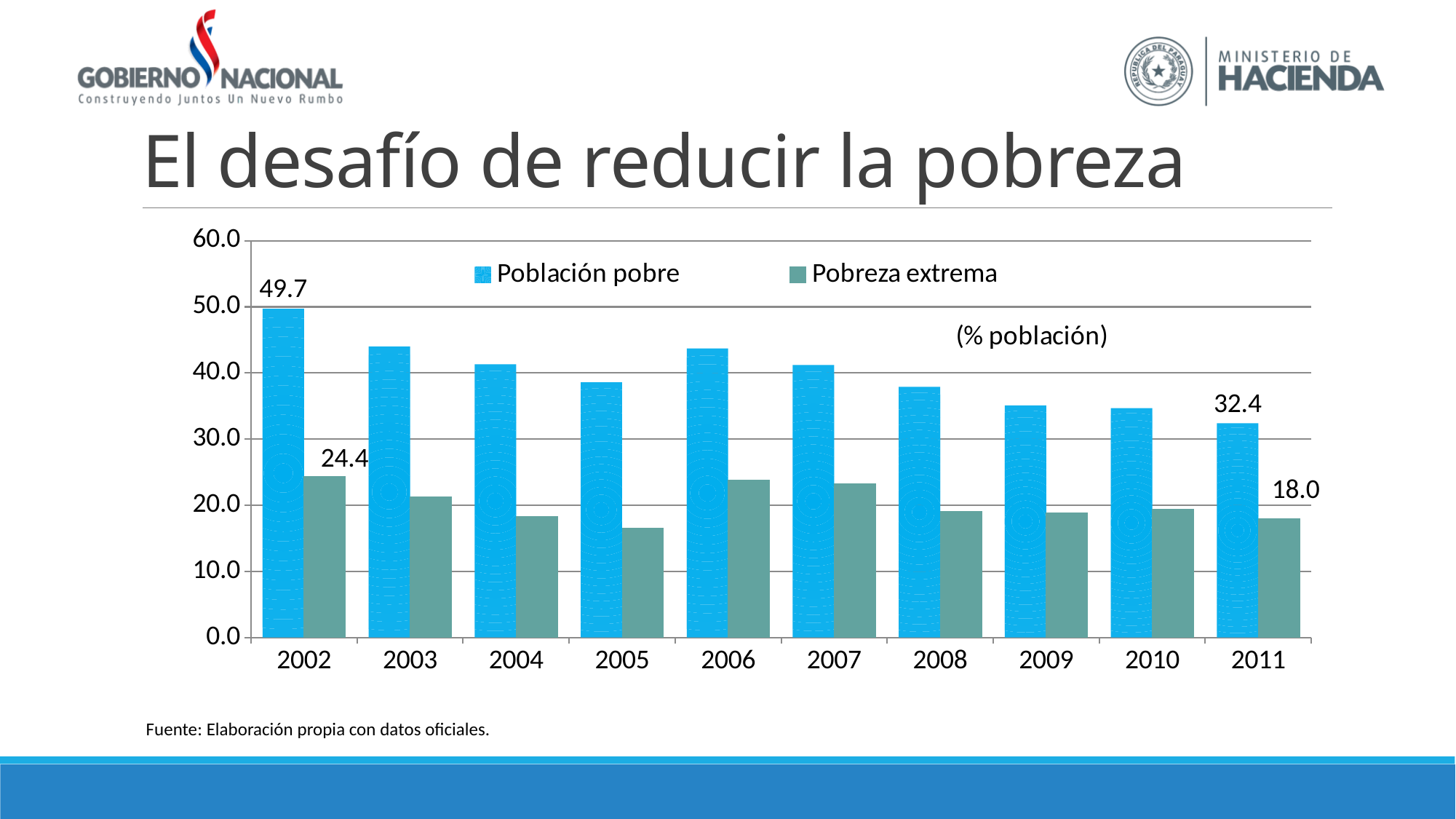
What is the value of Población pobre in 2002? 49.7 How many series does the legend list? 2 In which year is Población pobre highest? 2002 How many years are shown on the x axis? 10 What is the value of Pobreza extrema in 2011? 18.0 What is the value of Pobreza extrema in 2002? 24.4 In which year is Pobreza extrema lowest? 2005 What is the value of Población pobre in 2011? 32.4 Which is larger, Población pobre in 2003 or in 2004? 2003 What is the difference between Pobreza extrema in 2002 and in 2011? 6.4 By how much did Población pobre fall between 2002 and 2011? 17.3 Is the value for Población pobre in 2006 greater or less than 40.0? greater